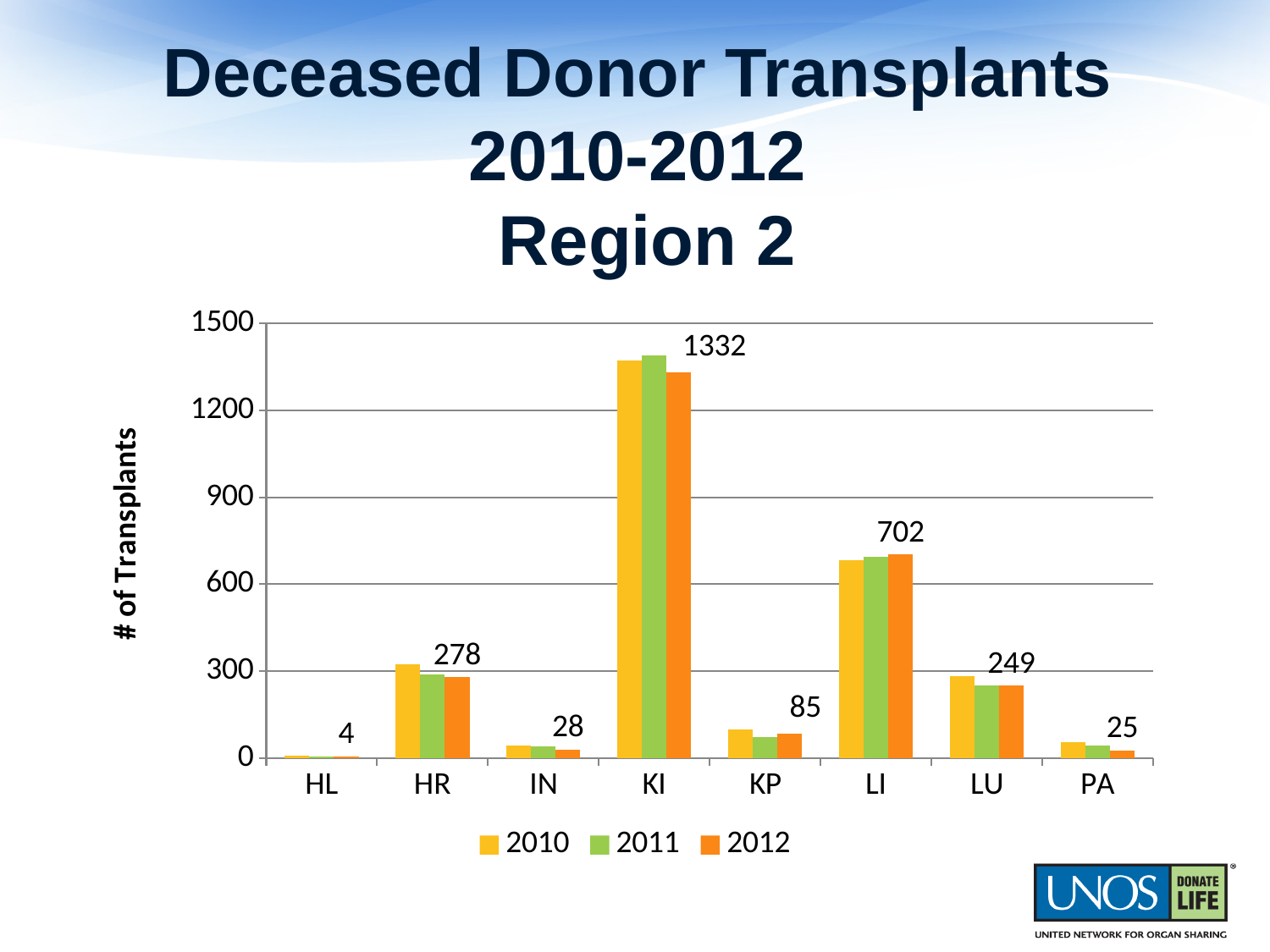
What is the 2012 value for LI? 702 How many organ categories are shown on the x axis? 8 Which organ category has the highest number of transplants in 2012? KI What is the difference between the 2012 values for KI and LI? 630 Is the 2010 value for KI greater or less than 1200? greater How many series does the legend list? 3 Which organ category has the lowest number of transplants in 2012? HL What is the 2012 value for HR? 278 Which is larger in 2012, HR or LU? HR What kind of chart is shown on the slide? Bar chart What is the 2012 value for KI? 1332